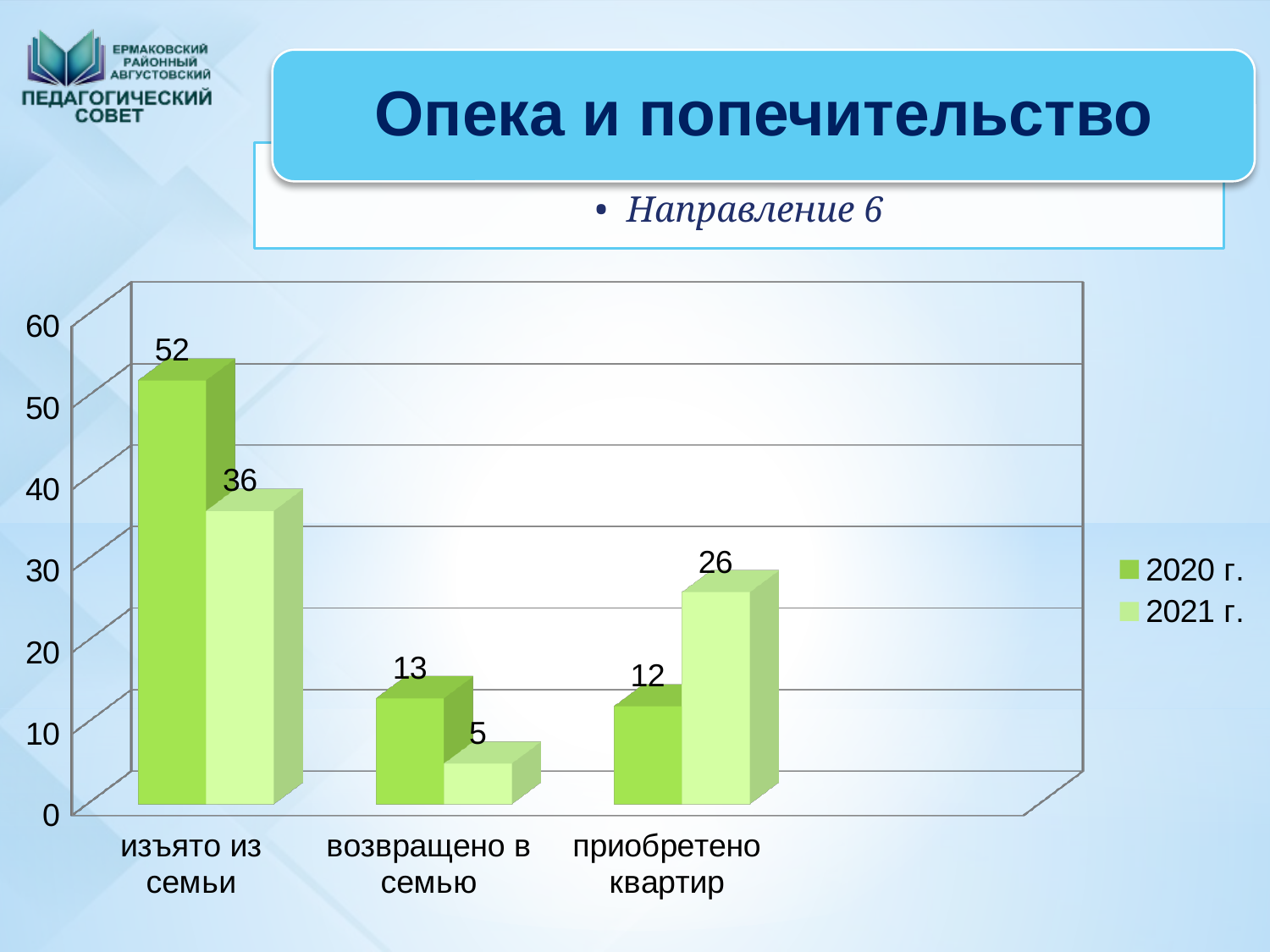
What is the value for "изъято из семьи" in the 2021 г. series? 36 Which category has the lowest value in the 2021 г. series? возвращено в семью What kind of chart is shown on the slide? bar chart What is the value for "приобретено квартир" in the 2020 г. series? 12 Which category has the highest value in the 2020 г. series? изъято из семьи What is the value for "изъято из семьи" in the 2020 г. series? 52 What is the difference between the 2020 г. and 2021 г. values for "изъято из семьи"? 16 How many categories are shown on the x axis? 3 What is the difference between the 2021 г. and 2020 г. values for "приобретено квартир"? 14 What is the value for "возвращено в семью" in the 2021 г. series? 5 How many series does the legend list? 2 For "приобретено квартир", which series has the larger value, 2020 г. or 2021 г.? 2021 г.